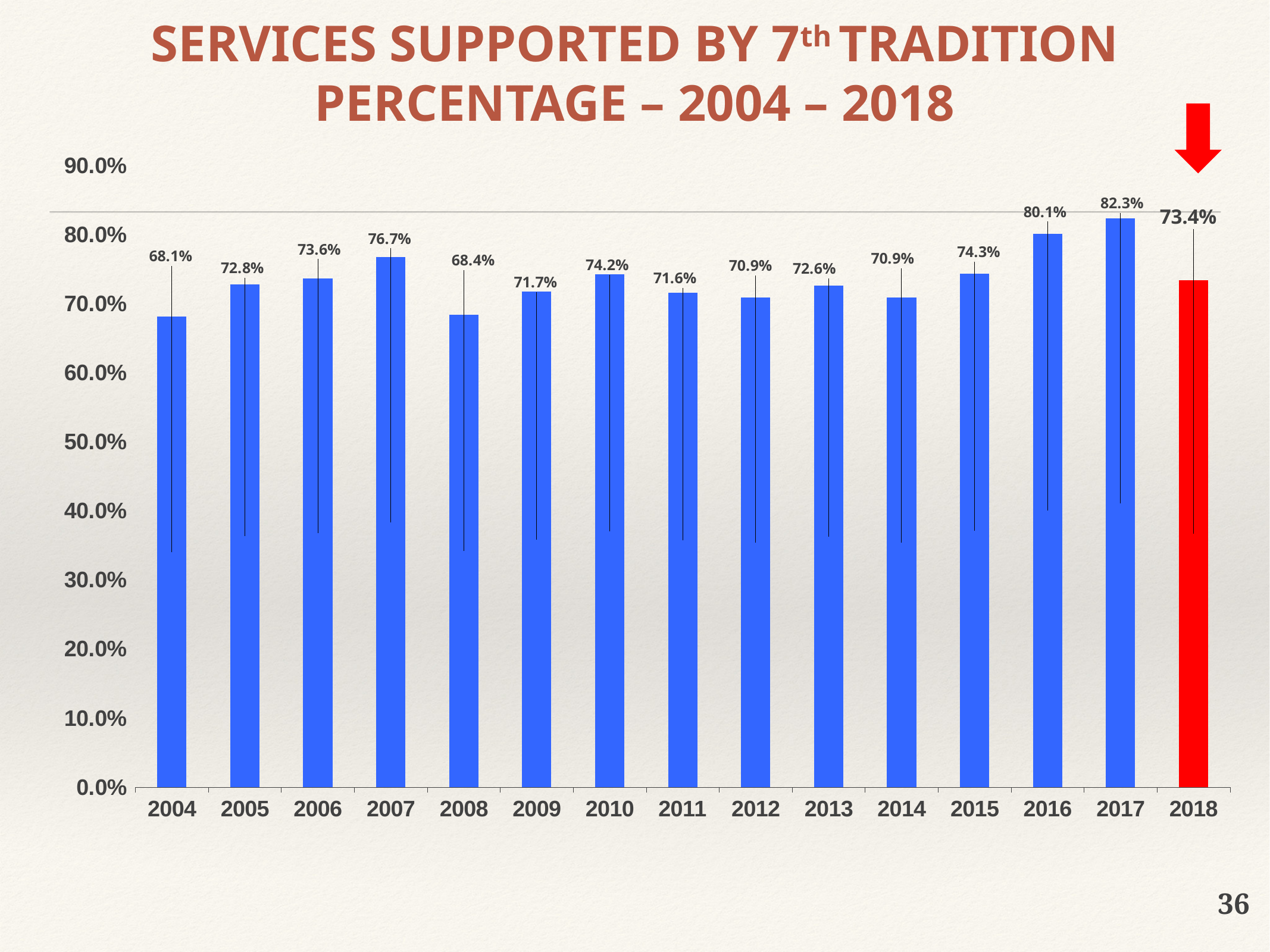
Do the values rise or fall from 2015 to 2017? rise What kind of chart is this? bar chart Which bar is coloured red? 2018 Which is larger, the value for 2007 or the value for 2008? 2007 What is the value for 2004? 68.1% Is the value for 2016 greater or less than 80.0%? greater What is the value for 2010? 74.2% How many years are shown on the x axis? 15 What is the difference between the values for 2017 and 2018? 8.9% What is the value for 2018? 73.4% Which year has the lowest value? 2004 Which year has the highest value? 2017